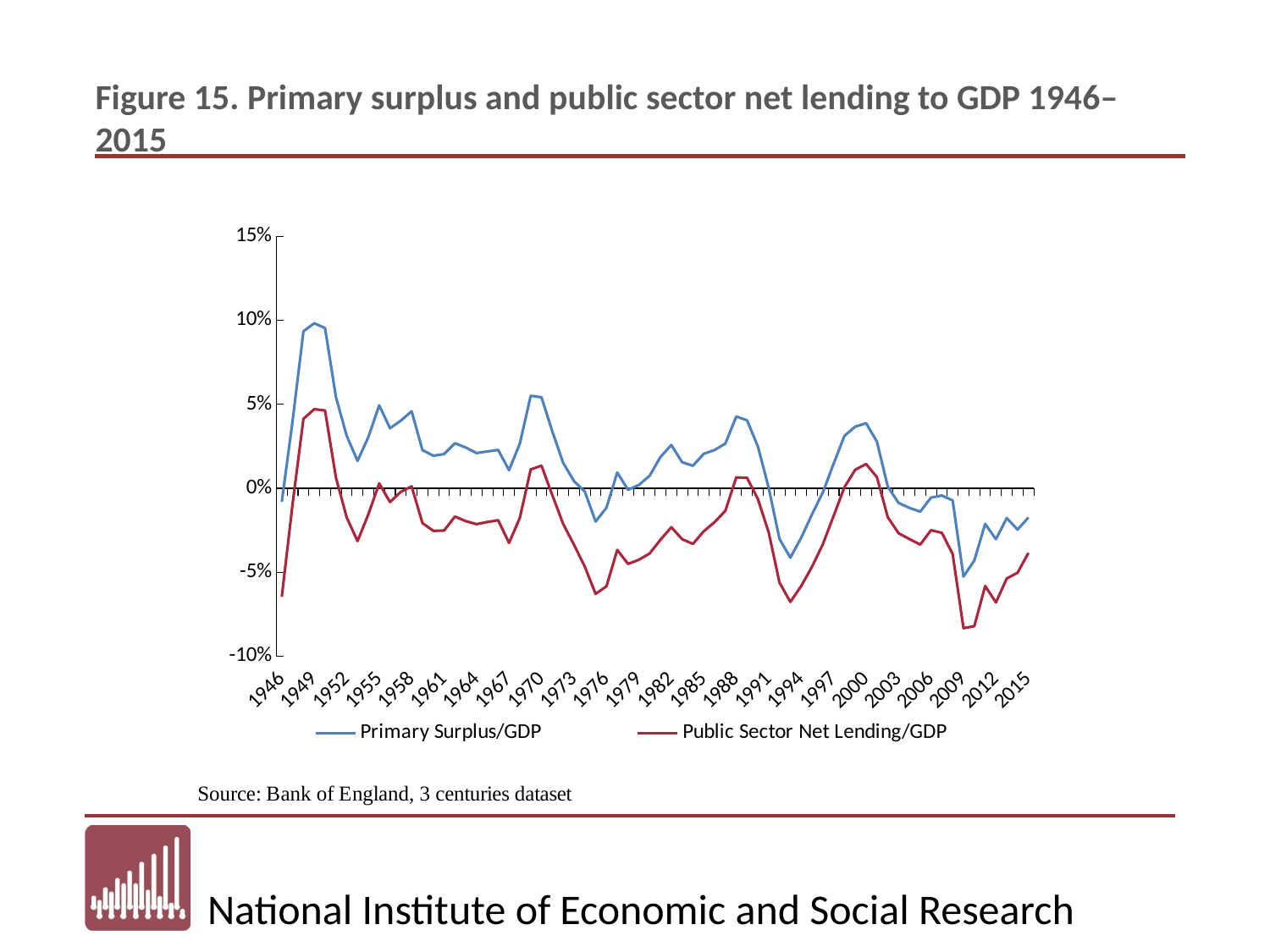
What are the two series named in the legend? Primary Surplus/GDP and Public Sector Net Lending/GDP Is the value for Public Sector Net Lending/GDP in 2009 greater or less than -5%? less What kind of chart is shown on the slide? line chart Does Primary Surplus/GDP rise or fall between 2000 and 2009? fall In 1949, which series has the higher value, Primary Surplus/GDP or Public Sector Net Lending/GDP? Primary Surplus/GDP Which series reaches the highest value anywhere on the chart? Primary Surplus/GDP Is the value for Primary Surplus/GDP in 1994 greater or less than 0%? less What is the source given below the chart? Bank of England, 3 centuries dataset Which series reaches the lowest value anywhere on the chart? Public Sector Net Lending/GDP Is the value for Public Sector Net Lending/GDP in 1949 greater or less than 0%? greater How many series does the legend list? 2